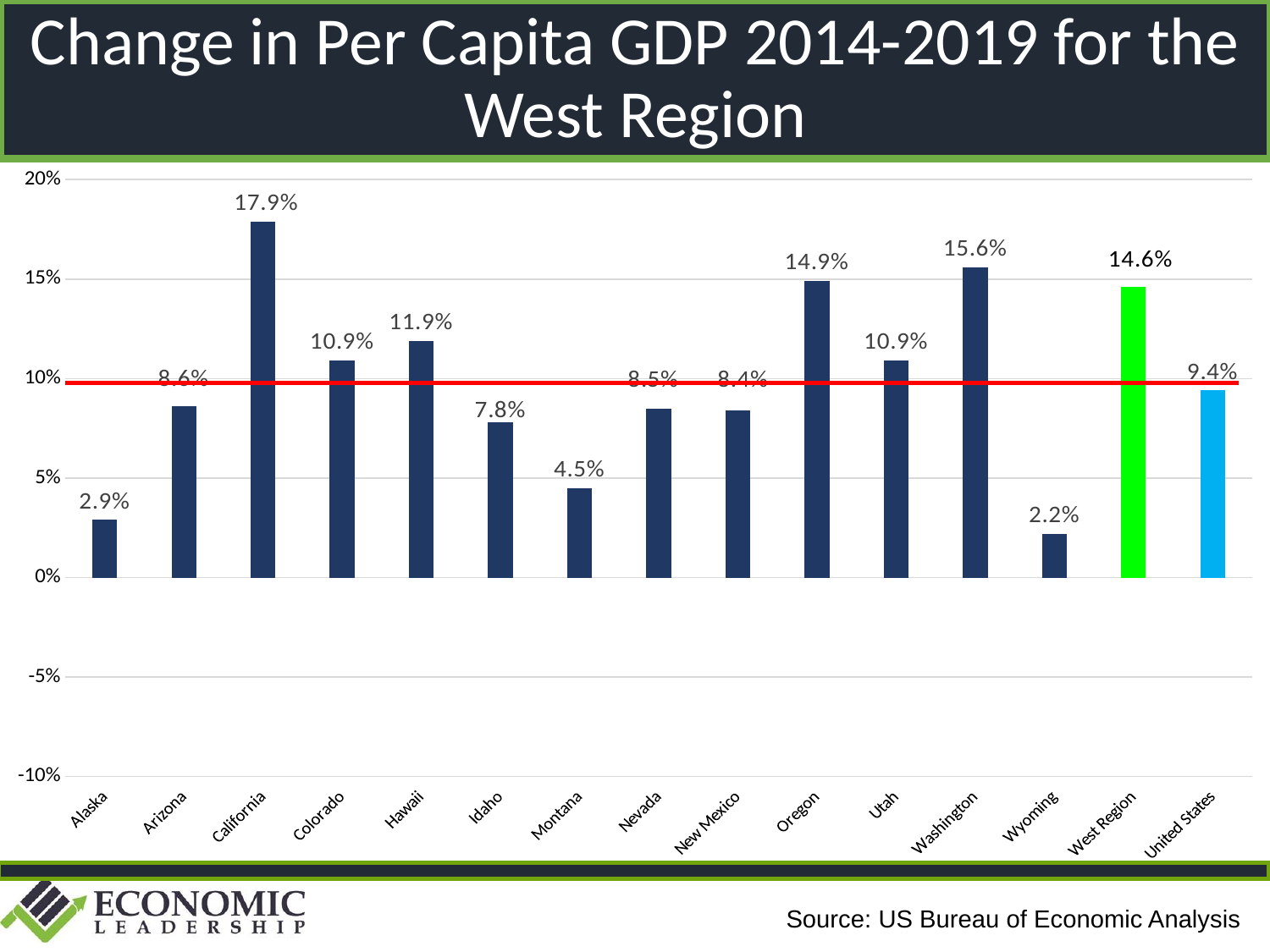
What is the value shown for the United States? 9.4% Which category has the lowest change in per capita GDP? Wyoming Which has a larger change in per capita GDP, Hawaii or Idaho? Hawaii What kind of chart is shown on the slide? Bar chart What is the value shown for Montana? 4.5% How many categories are shown on the x axis? 15 What is the change in per capita GDP for California? 17.9% Which state has the highest change in per capita GDP? California What is the difference between the values for California and Wyoming? 15.7% What is the difference between the values for Washington and Oregon? 0.7% What is the value shown for the West Region bar? 14.6% Is the value for Alaska greater or less than 5%? less